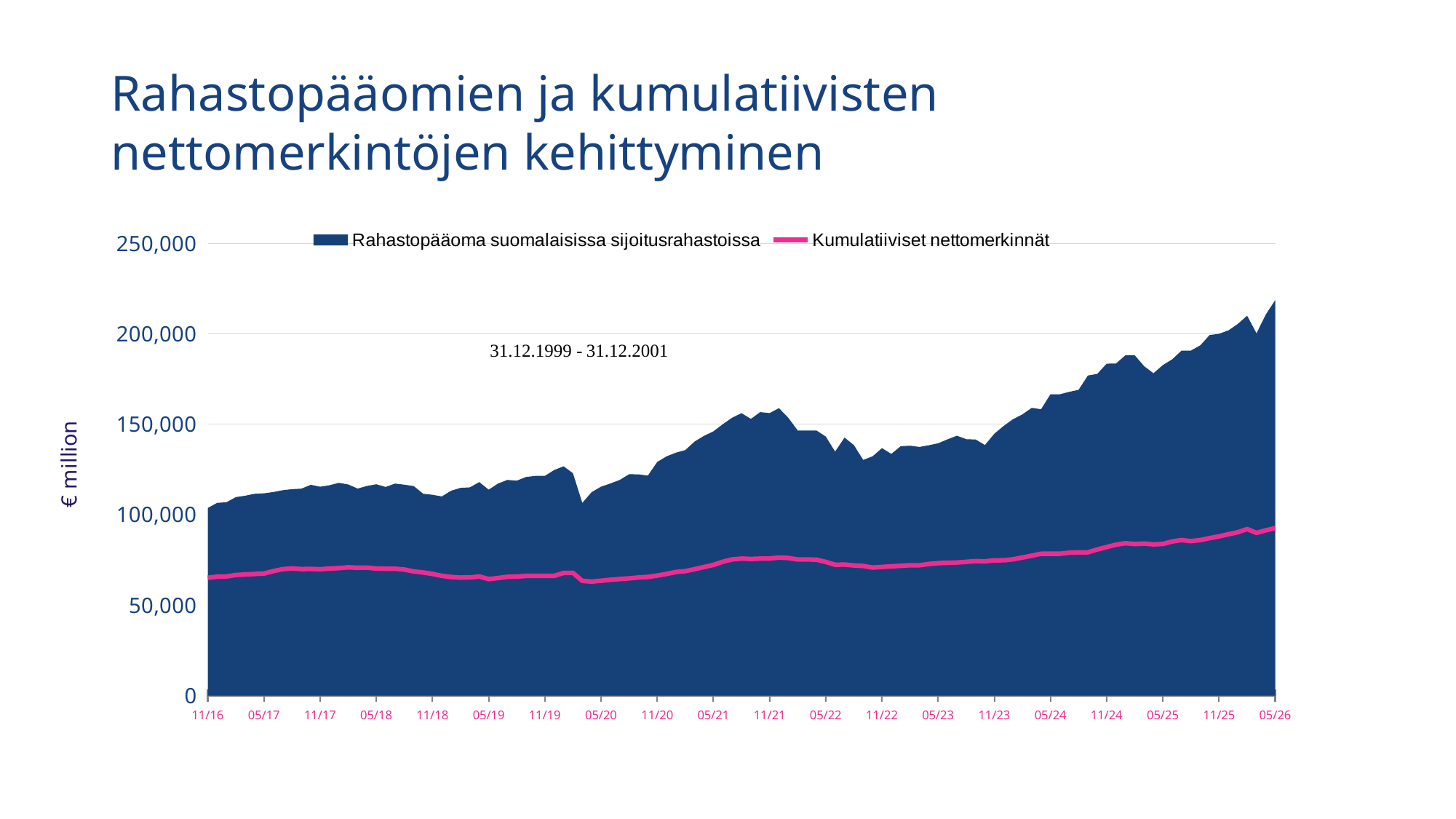
Overall, do the values for Rahastopääoma suomalaisissa sijoitusrahastoissa rise or fall from 11/16 to 05/26? rise Is the value for Rahastopääoma suomalaisissa sijoitusrahastoissa at 11/16 greater or less than 100,000? greater How many series does the legend list? 2 What is the label on the vertical axis? € million Is the value for Rahastopääoma suomalaisissa sijoitusrahastoissa at 05/26 greater or less than 200,000? greater What kind of chart is shown on the slide? combination area and line chart What are the two series named in the legend? Rahastopääoma suomalaisissa sijoitusrahastoissa; Kumulatiiviset nettomerkinnät Overall, do the values for Kumulatiiviset nettomerkinnät rise or fall from 11/16 to 05/26? rise Is the value for Rahastopääoma suomalaisissa sijoitusrahastoissa at 11/22 greater or less than 150,000? less Which series has the higher value at 05/26, Rahastopääoma suomalaisissa sijoitusrahastoissa or Kumulatiiviset nettomerkinnät? Rahastopääoma suomalaisissa sijoitusrahastoissa